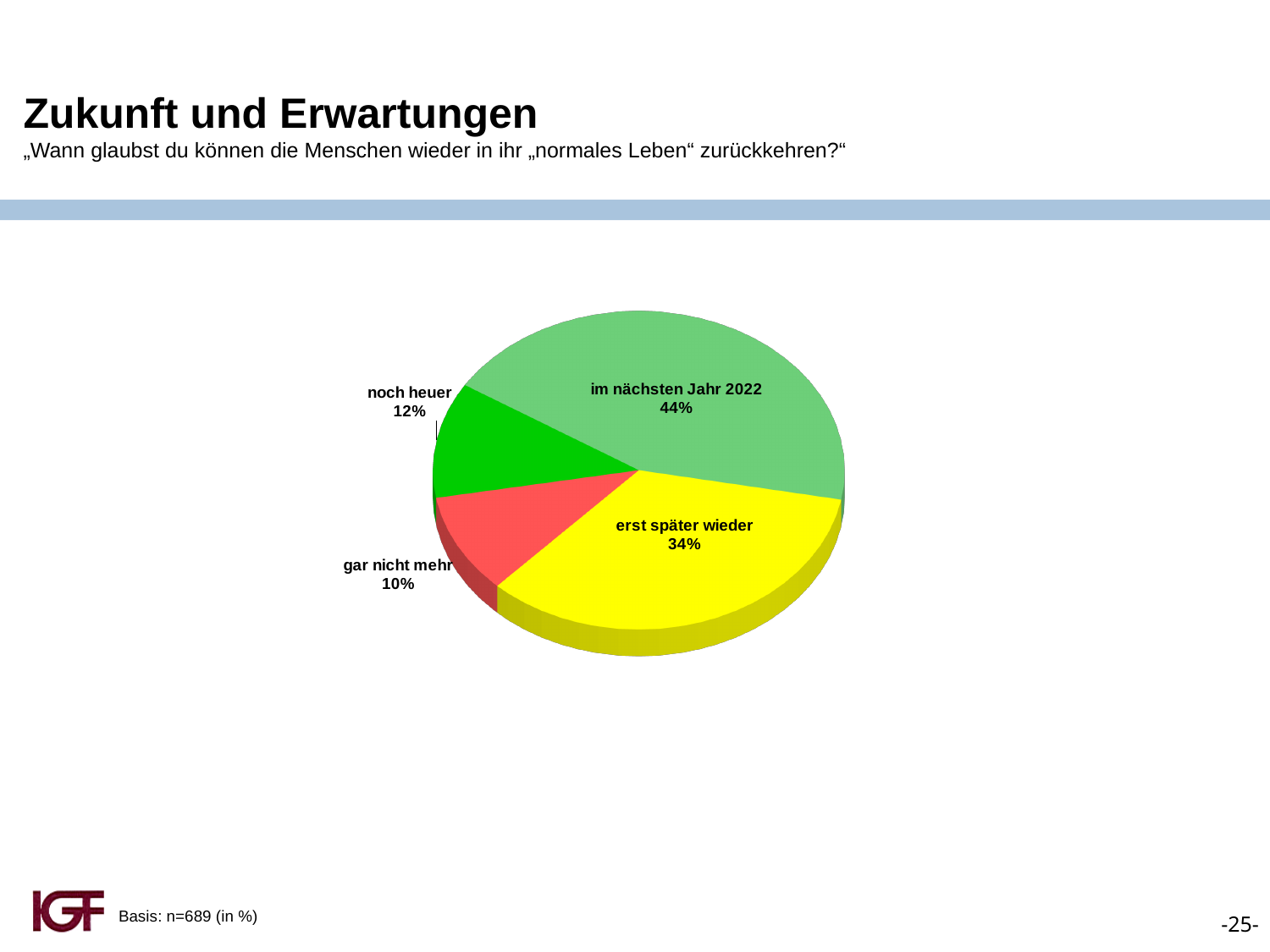
What share of respondents answered "erst später wieder"? 34% What share of respondents answered "gar nicht mehr"? 10% What kind of chart is shown on the slide? pie chart Which answer category has the smallest share of the pie? gar nicht mehr What share of respondents answered "im nächsten Jahr 2022"? 44% What share of respondents answered "noch heuer"? 12% How many slices does the pie chart have? 4 What is the combined share of "noch heuer" and "gar nicht mehr"? 22% Which is larger: the share for "noch heuer" or the share for "gar nicht mehr"? noch heuer Which answer category has the largest share of the pie? im nächsten Jahr 2022 What colour is the slice for "gar nicht mehr"? red What is the difference in percentage points between "im nächsten Jahr 2022" and "erst später wieder"? 10